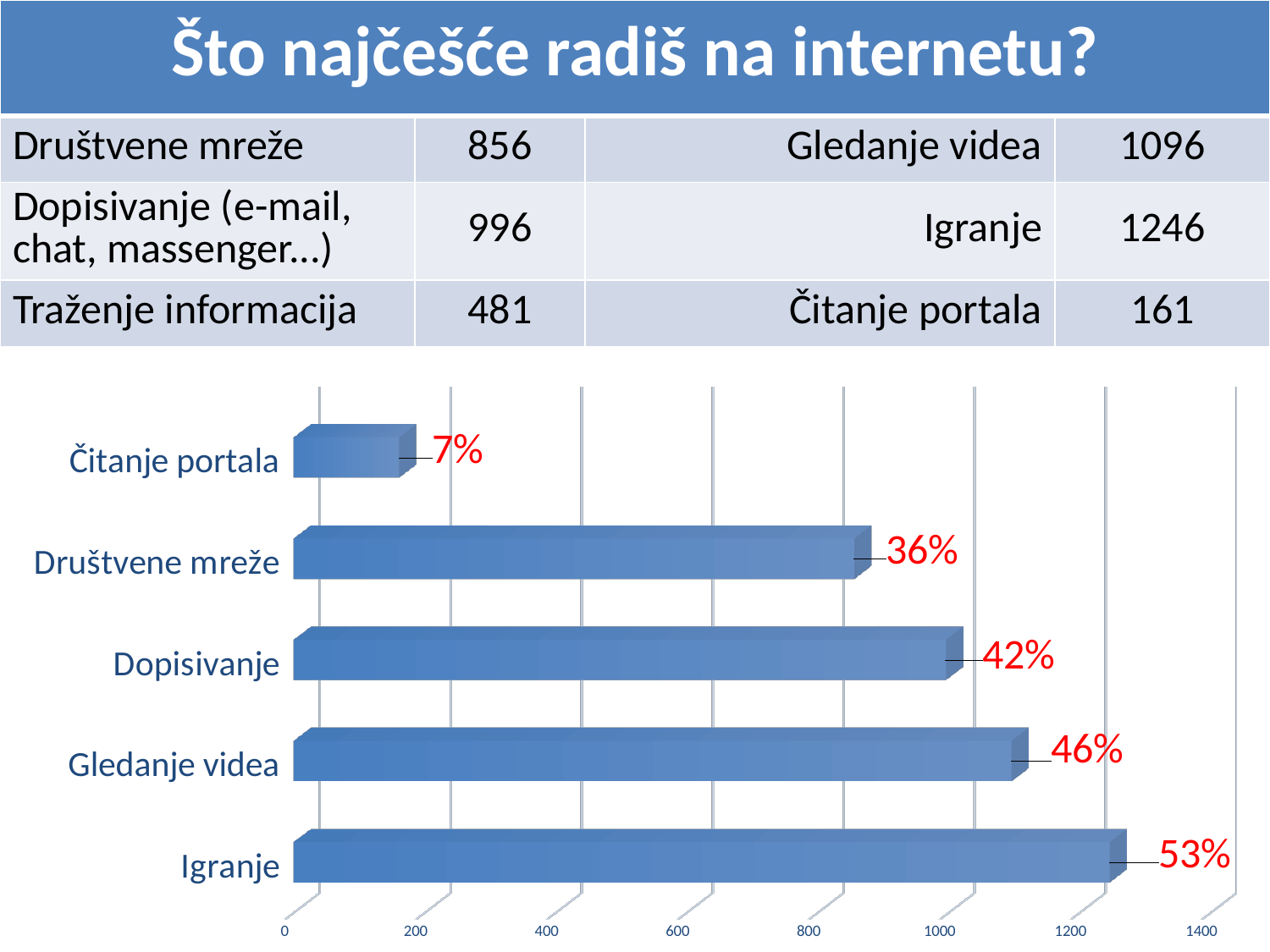
Which category has the shortest bar in the chart? Čitanje portala What is the data label shown for Igranje in the bar chart? 53% What kind of chart is shown on the slide? bar chart Is the bar for Igranje greater or less than 1200 on the axis? greater Which has a larger value in the bar chart, Društvene mreže or Gledanje videa? Gledanje videa What is the data label shown for Gledanje videa in the bar chart? 46% What is the data label shown for Dopisivanje in the bar chart? 42% What is the data label shown for Čitanje portala in the bar chart? 7% Which category has the longest bar in the chart? Igranje Is the bar for Čitanje portala greater or less than 200 on the axis? less How many categories does the bar chart show? 5 What is the difference in percentage points between the labels for Igranje and Čitanje portala? 46